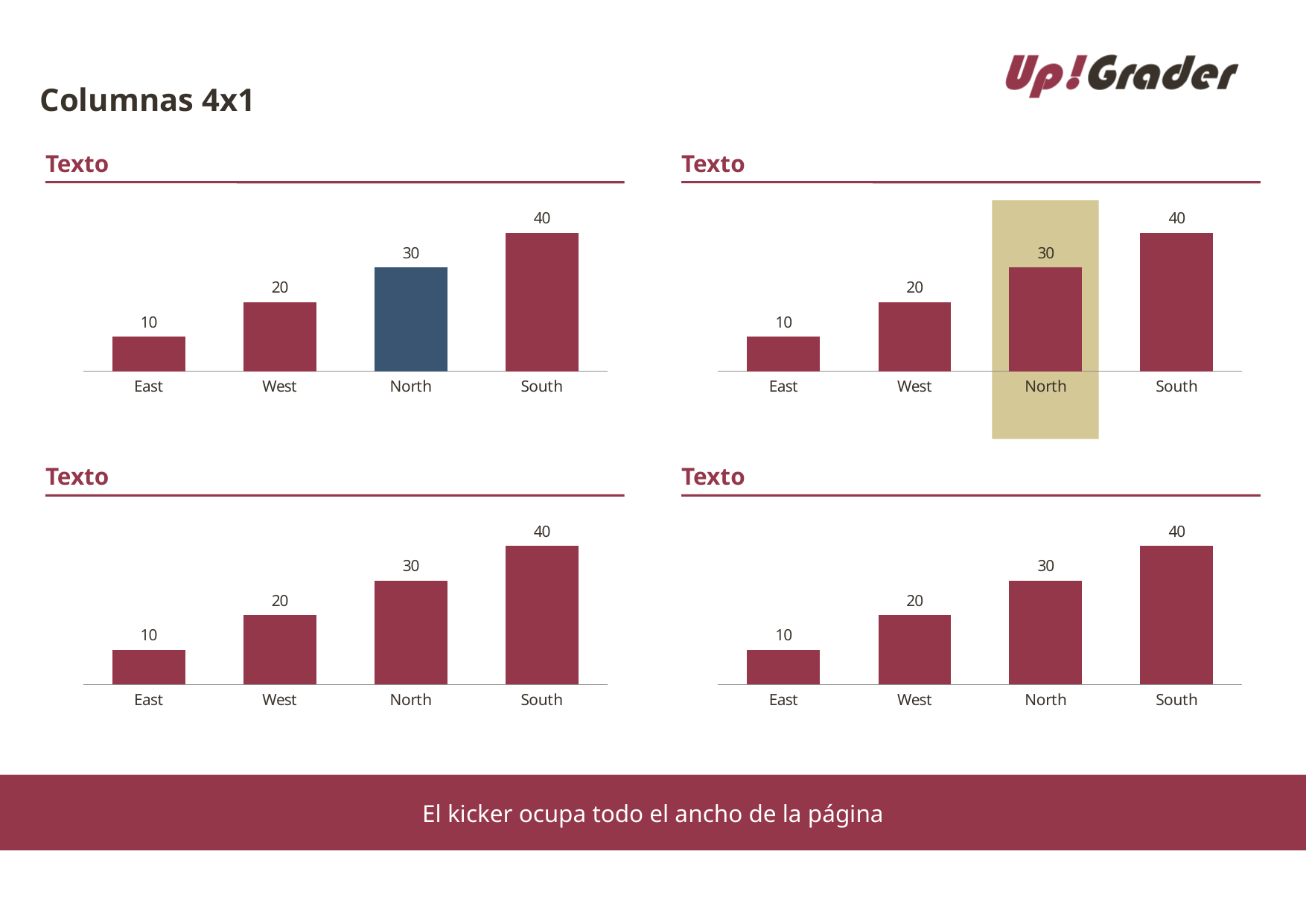
In the bottom-right chart, which category has the highest value? South In the bottom-left chart, what is the difference between the values for South and East? 30 In the top-left chart, which category has the lowest value? East In the top-right chart, which category is highlighted with a shaded background? North How many categories are shown in the bottom-right chart? 4 In the bottom-left chart, do the values rise or fall from East to South? Rise What kind of chart is the top-left chart? Bar chart In the bottom-left chart, what is the value for West? 20 In the top-right chart, what is the value for East? 10 In the top-left chart, which bar is coloured differently from the others? North In the top-left chart, what is the value for North? 30 In the top-right chart, which is larger, the value for West or the value for North? North